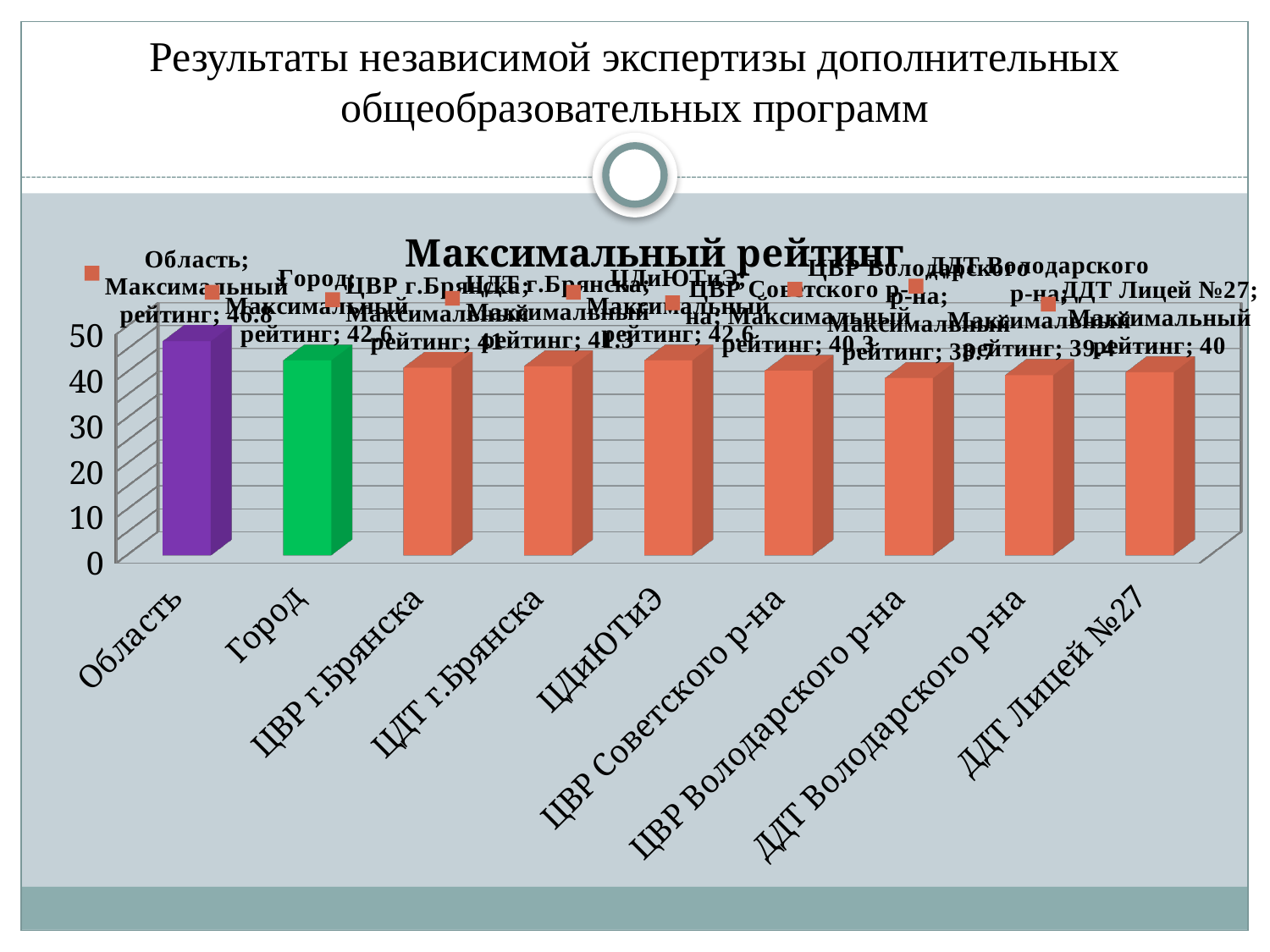
What is the value for ЦВР Советского р-на? 40.3 How many categories are plotted in the chart? 9 Is the value for ЦВР Володарского р-на greater or less than 30? greater What is the value for Область? 46.8 What is the difference between the values for Область and Город? 4.2 What is the title of the chart? Максимальный рейтинг Which is larger, the value for Область or the value for ЦДиЮТиЭ? Область What is the value for ДДТ Лицей №27? 40 Which category has the highest value? Область What is the value for Город? 42.6 What is the value for ЦДиЮТиЭ? 42.6 What kind of chart is shown on the slide? bar chart